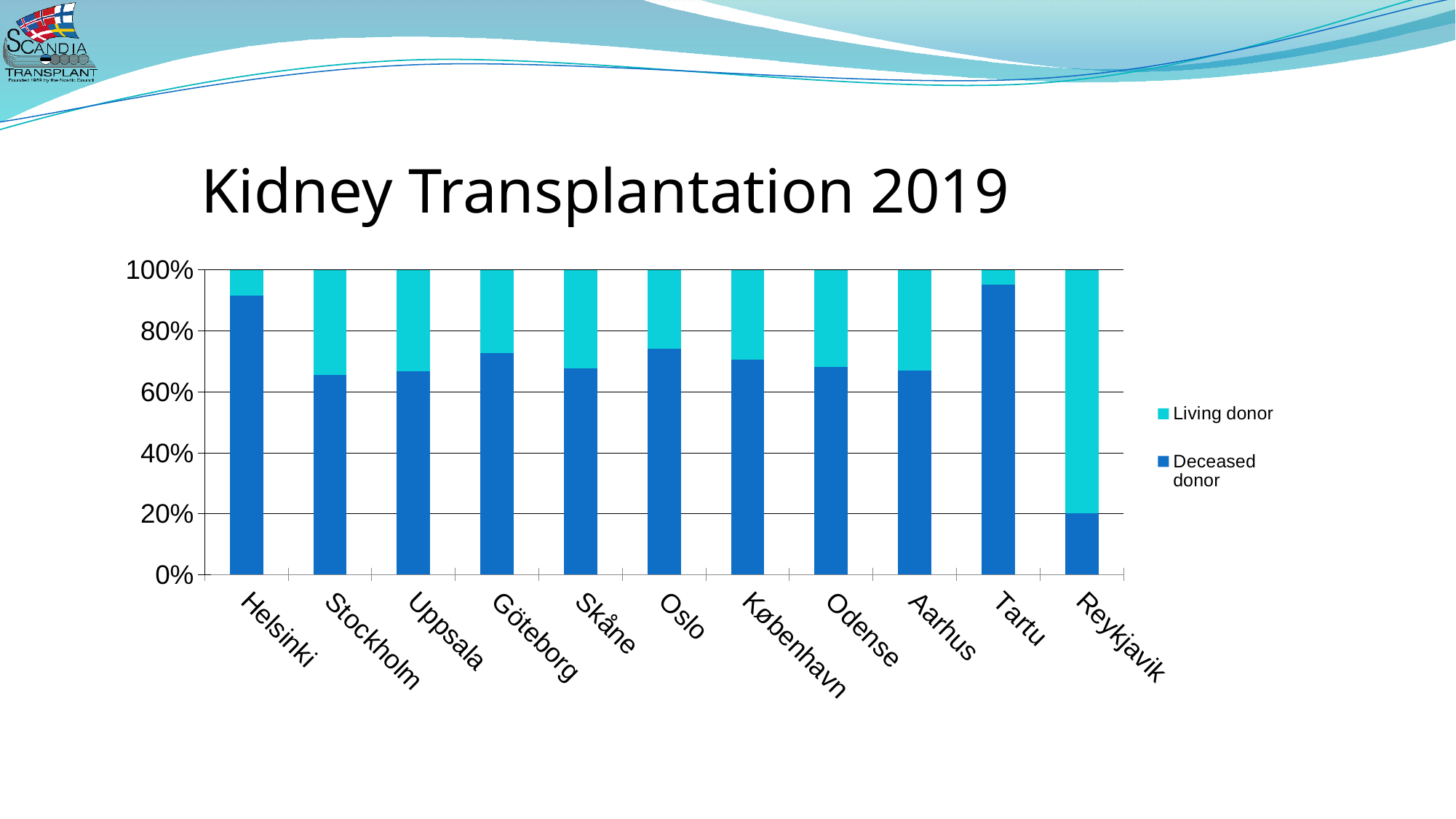
Which centre has the lowest Deceased donor share? Reykjavik Which centre has the highest Living donor share? Reykjavik How many centres (categories) are shown on the x axis of the chart? 11 Which two series are listed in the chart's legend? Living donor and Deceased donor Which has the larger Living donor share, Oslo or Reykjavik? Reykjavik Is the Deceased donor share for Helsinki greater or less than 80%? greater Is the Deceased donor share for Oslo greater or less than 80%? less Which has the larger Deceased donor share, Göteborg or Stockholm? Göteborg What kind of chart is shown on the slide? Stacked bar chart What is the title of the slide containing the chart? Kidney Transplantation 2019 Is the Deceased donor share for Reykjavik greater or less than 40%? less How many series does the chart's legend list? 2